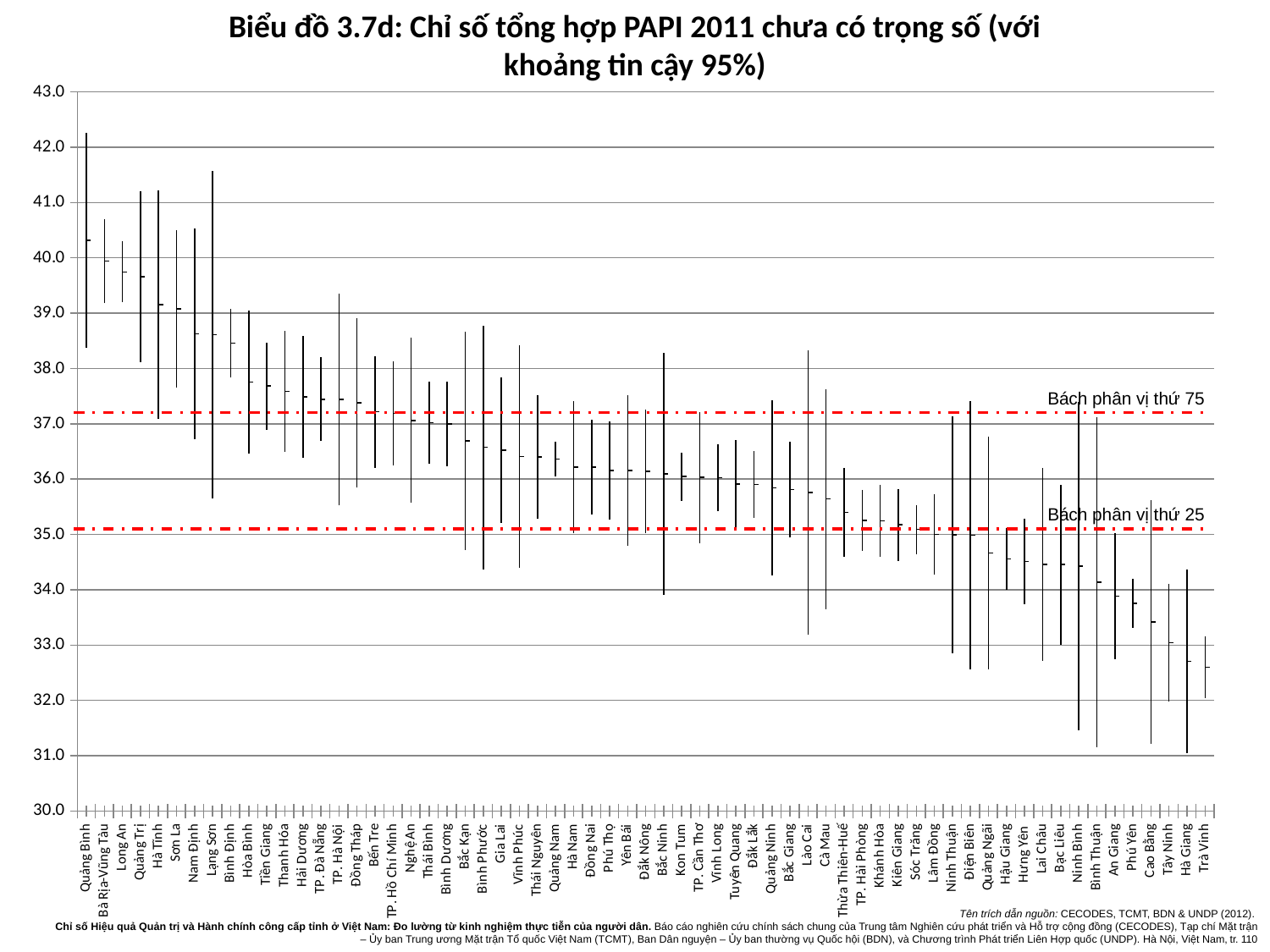
Is the point estimate for Thừa Thiên-Huế greater or less than 36.0? less What is the title of the chart? Biểu đồ 3.7d: Chỉ số tổng hợp PAPI 2011 chưa có trọng số (với khoảng tin cậy 95%) What are the two dashed red horizontal reference lines labelled? Bách phân vị thứ 75 and Bách phân vị thứ 25 Is the point estimate for Lạng Sơn greater or less than 38.0? greater Is the point estimate for Gia Lai greater or less than 36.0? greater Do the point estimates rise or fall moving from left to right along the x axis? Fall What kind of chart is shown on the slide? A chart of point estimates with 95% confidence interval error bars for each province How many provinces are plotted along the x axis? 63 Which province has the highest point estimate? Quảng Bình